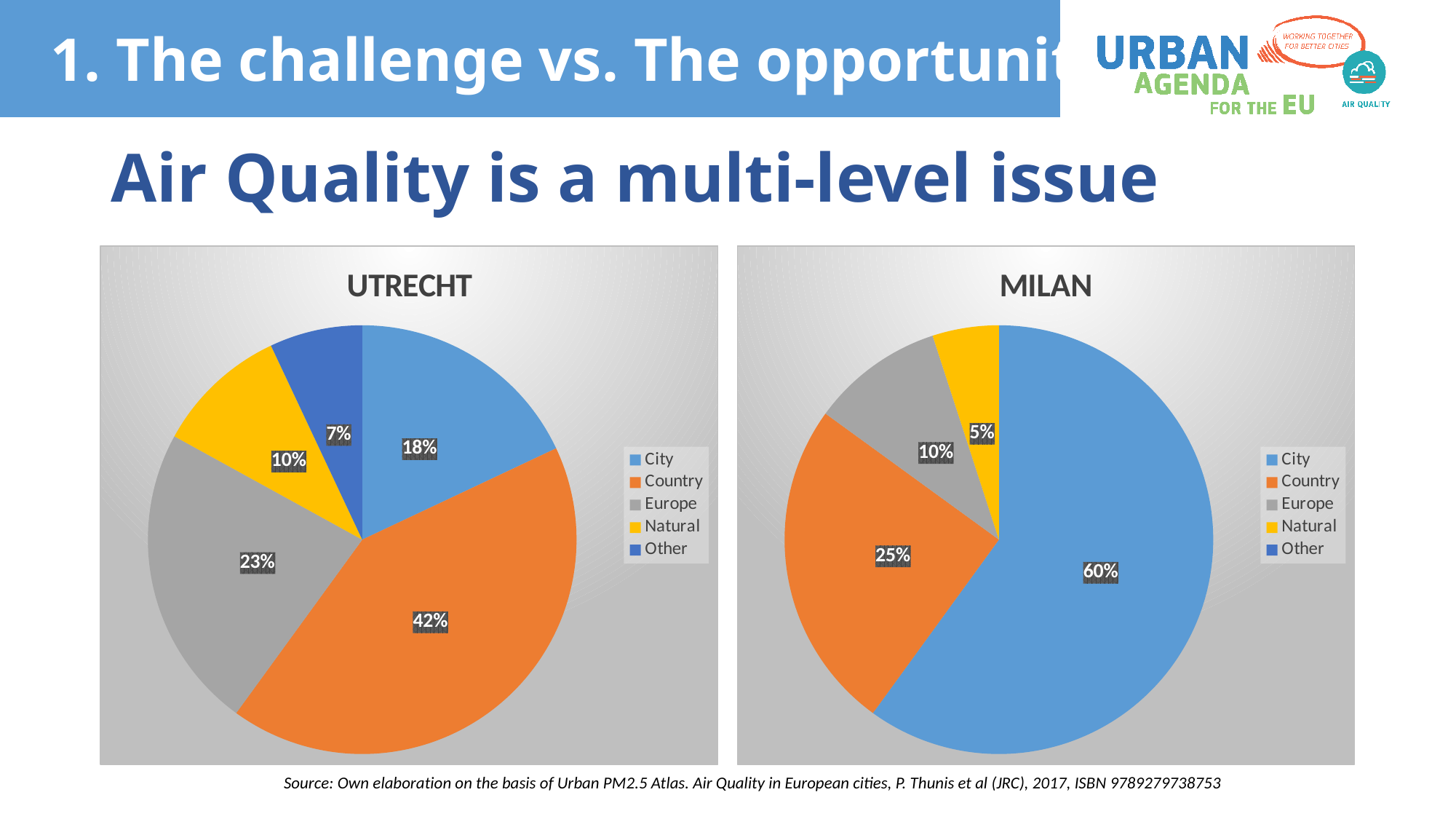
In the MILAN chart, which labelled category has the largest share? City What kind of chart is the MILAN chart? Pie chart In the UTRECHT chart, which category has the smallest share? Other In the MILAN chart, what is the difference between the City and Country shares? 35% In the MILAN chart, what is the value for Natural? 5% In the UTRECHT chart, what is the value for Europe? 23% In the UTRECHT chart, which category has the largest share? Country In the MILAN chart, what share does City account for? 60% Which is larger in the UTRECHT chart, the Europe share or the Natural share? Europe In the UTRECHT chart, what is the difference between the Country and City shares? 24% How many entries does the legend of the UTRECHT chart list? 5 In the UTRECHT chart, what share does Country account for? 42%